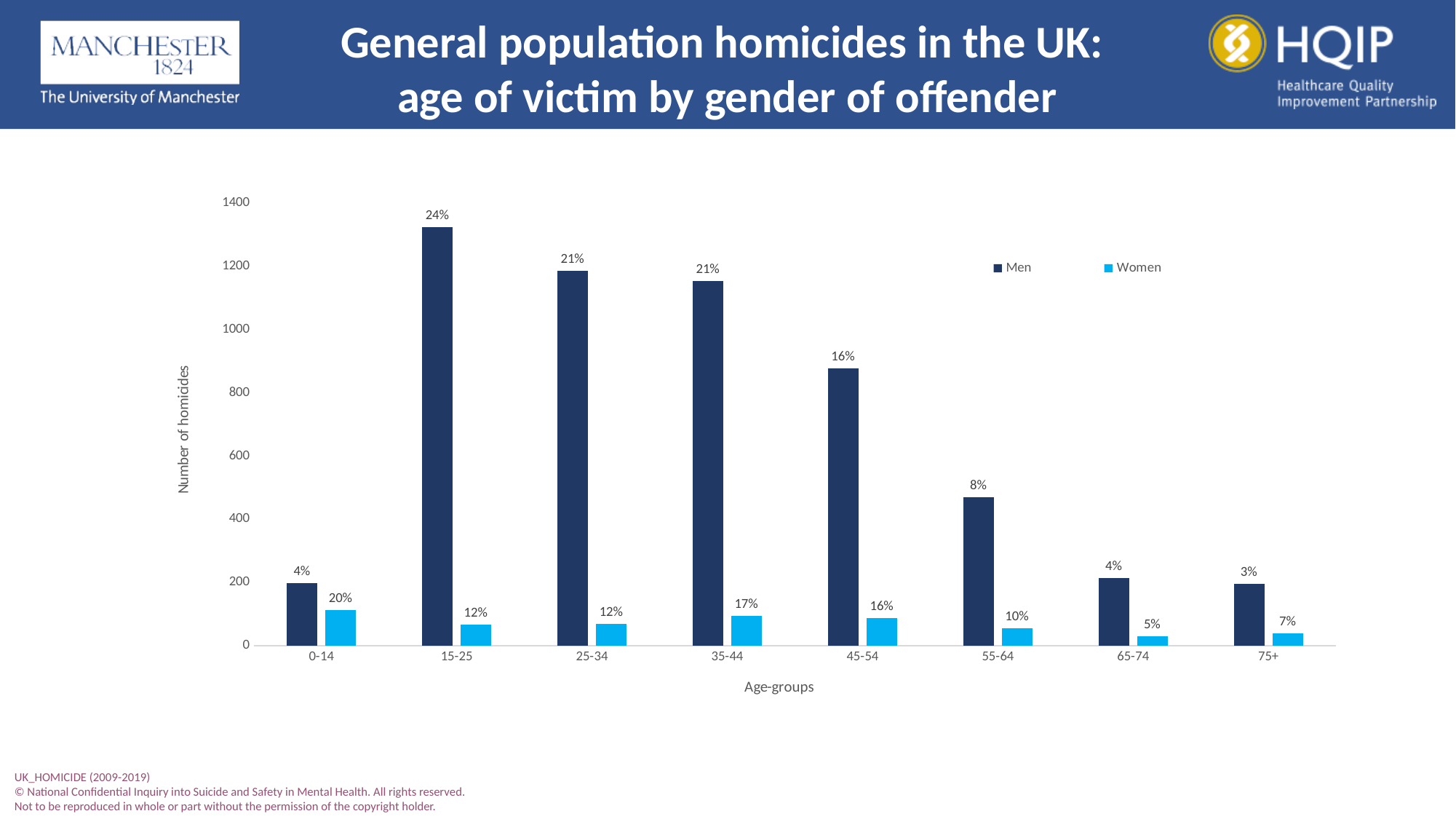
Is the Men bar for the 15-25 age group greater or less than 1200 homicides? greater Is the Women bar for the 0-14 age group greater or less than 200 homicides? less What kind of chart is shown on the slide? Bar chart How many age groups are shown on the x axis? 8 Which age group has the highest Men bar? 15-25 Which age group has the lowest Men bar? 75+ What percentage label is shown on the Men bar for the 15-25 age group? 24% What percentage label is shown on the Women bar for the 65-74 age group? 5% How many series does the legend list? 2 Which age group has the highest Women bar? 0-14 What percentage label is shown on the Women bar for the 0-14 age group? 20% Which is larger: the Women bar for 0-14 or the Women bar for 15-25? 0-14